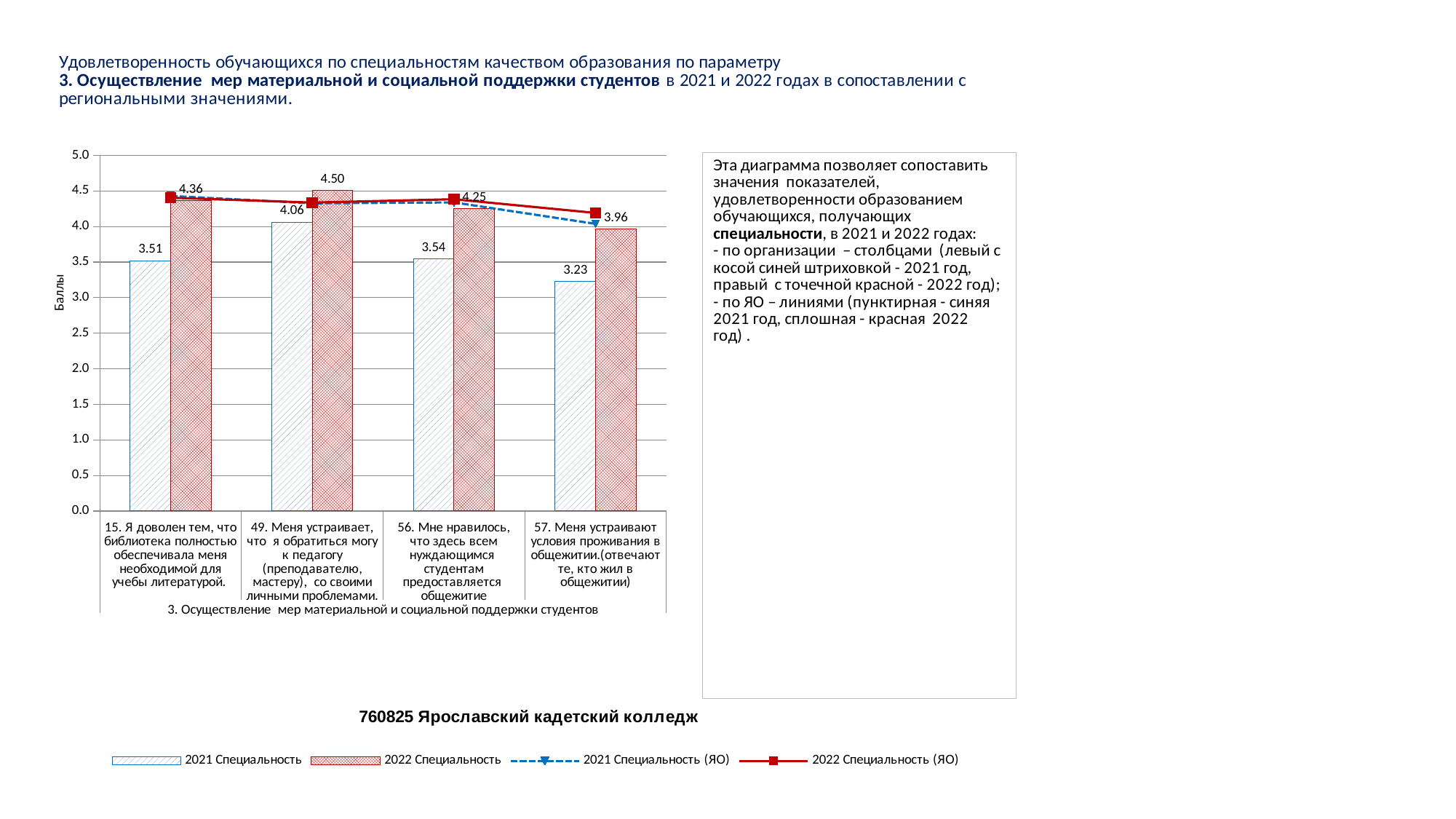
Which question has the highest 2022 Специальность value? 49. Меня устраивает, что я обратиться могу к педагогу (преподавателю, мастеру), со своими личными проблемами. How many series does the legend list? 4 What is the label of the y axis? Баллы Which is larger for question 56: the 2021 Специальность value or the 2022 Специальность value? 2022 Специальность What is the difference between the 2022 and 2021 Специальность values for question 15? 0.85 What is the 2021 Специальность value for question 15 (library provision)? 3.51 Which question has the lowest 2021 Специальность value? 57. Меня устраивают условия проживания в общежитии.(отвечают те, кто жил в общежитии) What is the 2022 Специальность value for question 49 (ability to approach a teacher with personal problems)? 4.50 What is the 2022 Специальность value for question 57 (dormitory living conditions)? 3.96 What type of chart is used for the Специальность values by organisation? bar chart How many question categories are shown on the x axis? 4 Is the 2021 Специальность (ЯО) line value for question 57 greater or less than 4.5? less